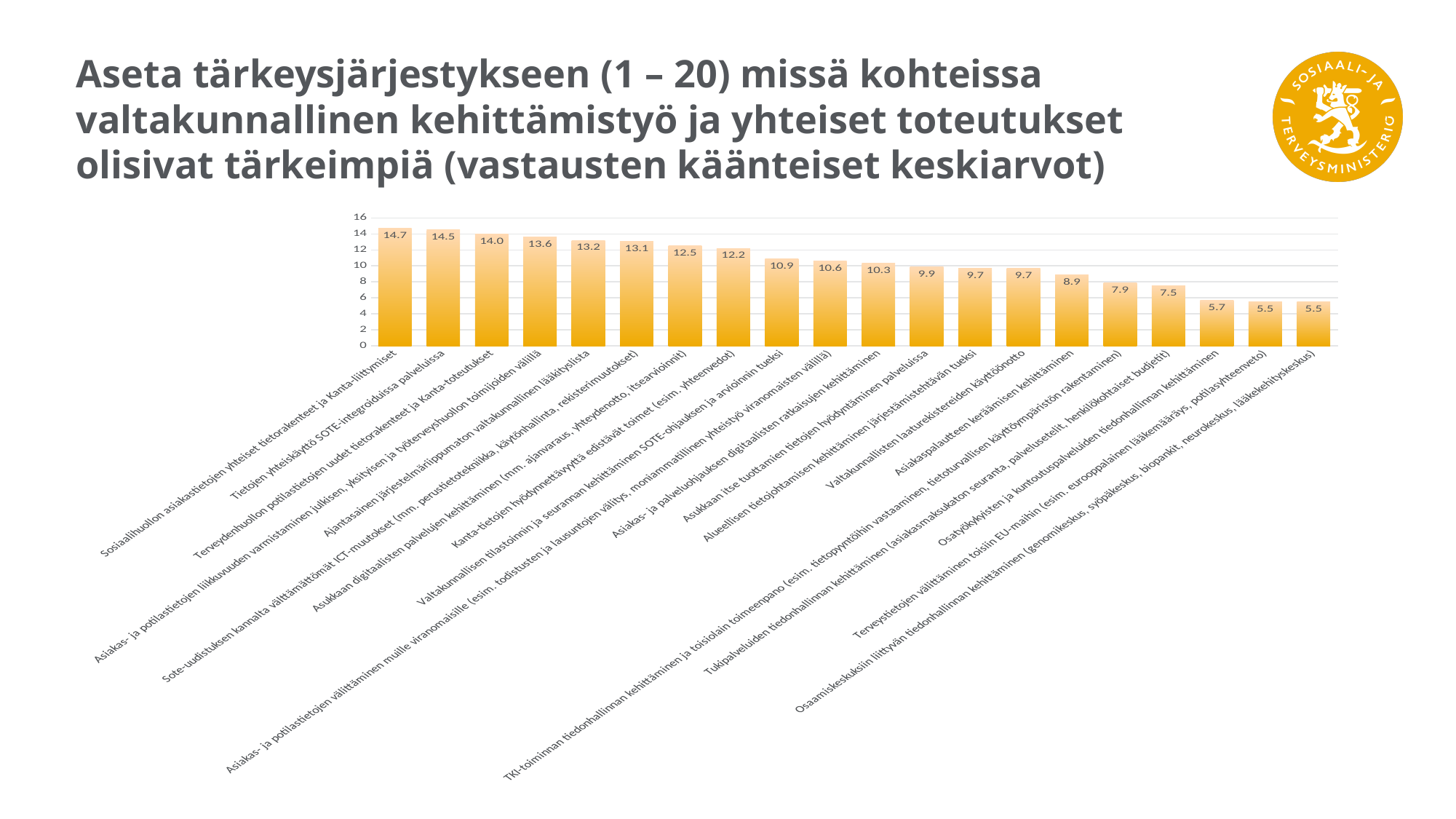
What is the value for Osatyökykyisten ja kuntoutuspalveluiden tiedonhallinnan kehittäminen? 5.7 What is the value for Valtakunnallisten laaturekistereiden käyttöönotto? 9.7 What is the highest value shown on the vertical axis? 16 What is the difference between the value for Sosiaalihuollon asiakastietojen yhteiset tietorakenteet ja Kanta-liittymiset and the value for Osatyökykyisten ja kuntoutuspalveluiden tiedonhallinnan kehittäminen? 9.0 How many bars (categories) does the chart show? 20 Do the values generally rise or fall from left to right along the x axis? fall Is the value for Asiakaspalautteen keräämisen kehittäminen greater or less than 8? greater What is the value for Ajantasainen järjestelmäriippumaton valtakunnallinen lääkityslista? 13.2 What kind of chart is shown on the slide? bar chart Which is larger: the value for Asukkaan digitaalisten palvelujen kehittäminen or the value for Asiakaspalautteen keräämisen kehittäminen? Asukkaan digitaalisten palvelujen kehittäminen What is the value for Tietojen yhteiskäyttö SOTE-integroiduissa palveluissa? 14.5 Which category has the highest value in the chart? Sosiaalihuollon asiakastietojen yhteiset tietorakenteet ja Kanta-liittymiset